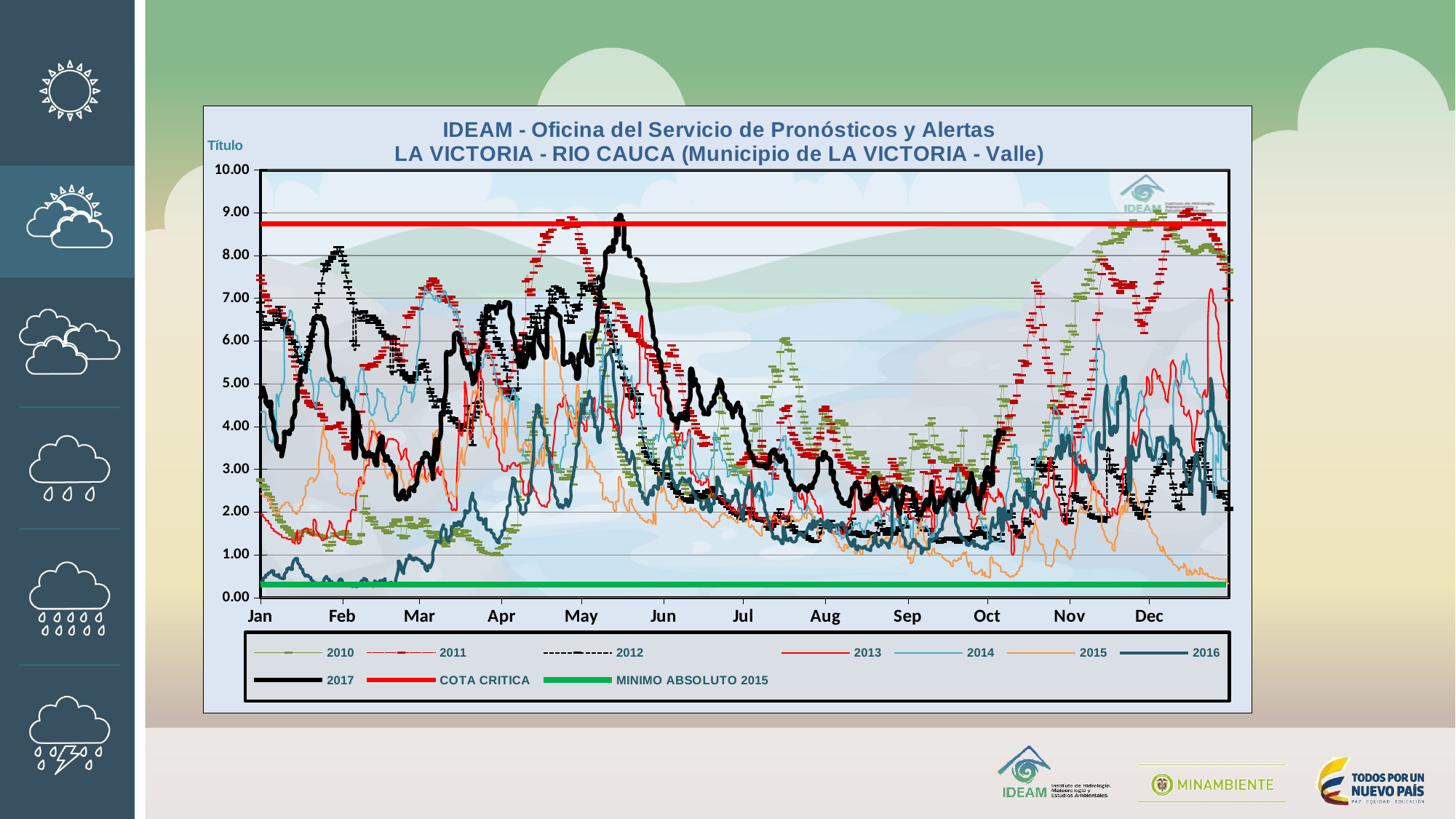
Is the value of the 2015 series in December greater or less than 1.00? less Is the MINIMO ABSOLUTO 2015 line greater or less than 1.00? less What kind of chart is shown on the slide? line chart How many month labels are shown along the x axis? 12 How many series does the legend list? 10 Which is higher on the chart, the COTA CRITICA line or the MINIMO ABSOLUTO 2015 line? COTA CRITICA What colour is the COTA CRITICA line in the legend? red Is the peak of the 2017 series in late May greater or less than 8.00? greater What is the highest value shown on the y axis? 10.00 Does the 2015 series rise or fall from June to December? fall